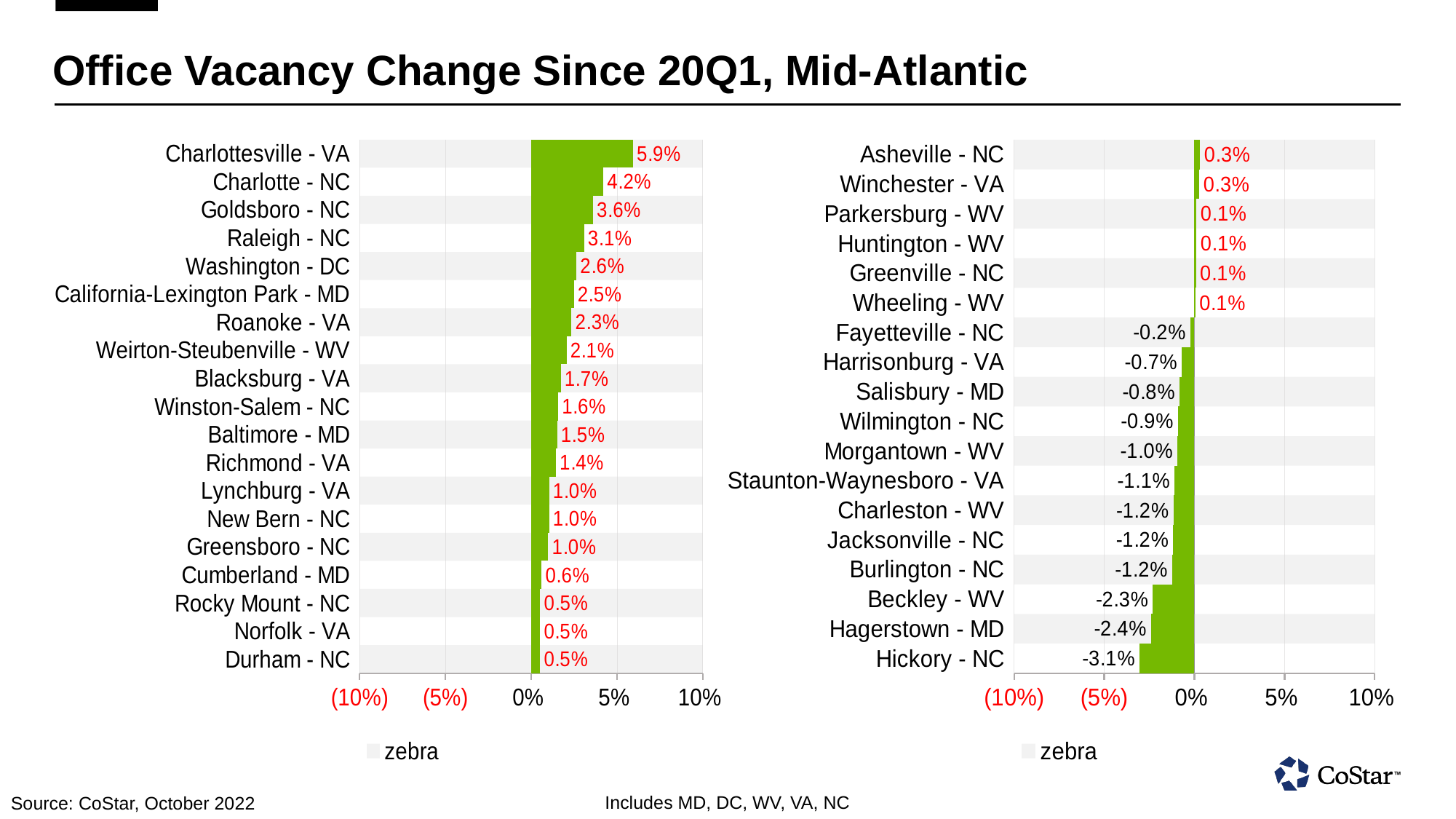
What type of chart is used on the left side of the slide? Bar chart On the right chart, which market has the lowest vacancy change? Hickory - NC On the left chart, which market has the highest vacancy change? Charlottesville - VA On the left chart, what is the office vacancy change for Charlotte - NC? 4.2% On the left chart, which is larger, the value for Raleigh - NC or the value for Roanoke - VA? Raleigh - NC How many markets are listed on the right chart? 18 On the right chart, what is the value shown for Hickory - NC? -3.1% On the left chart, what is the value shown for Washington - DC? 2.6% How many markets are listed on the left chart? 19 On the right chart, what is the difference between the values for Hagerstown - MD and Beckley - WV? 0.1% On the right chart, what is the value shown for Morgantown - WV? -1.0% On the left chart, what is the difference between the values for Charlottesville - VA and Charlotte - NC? 1.7%